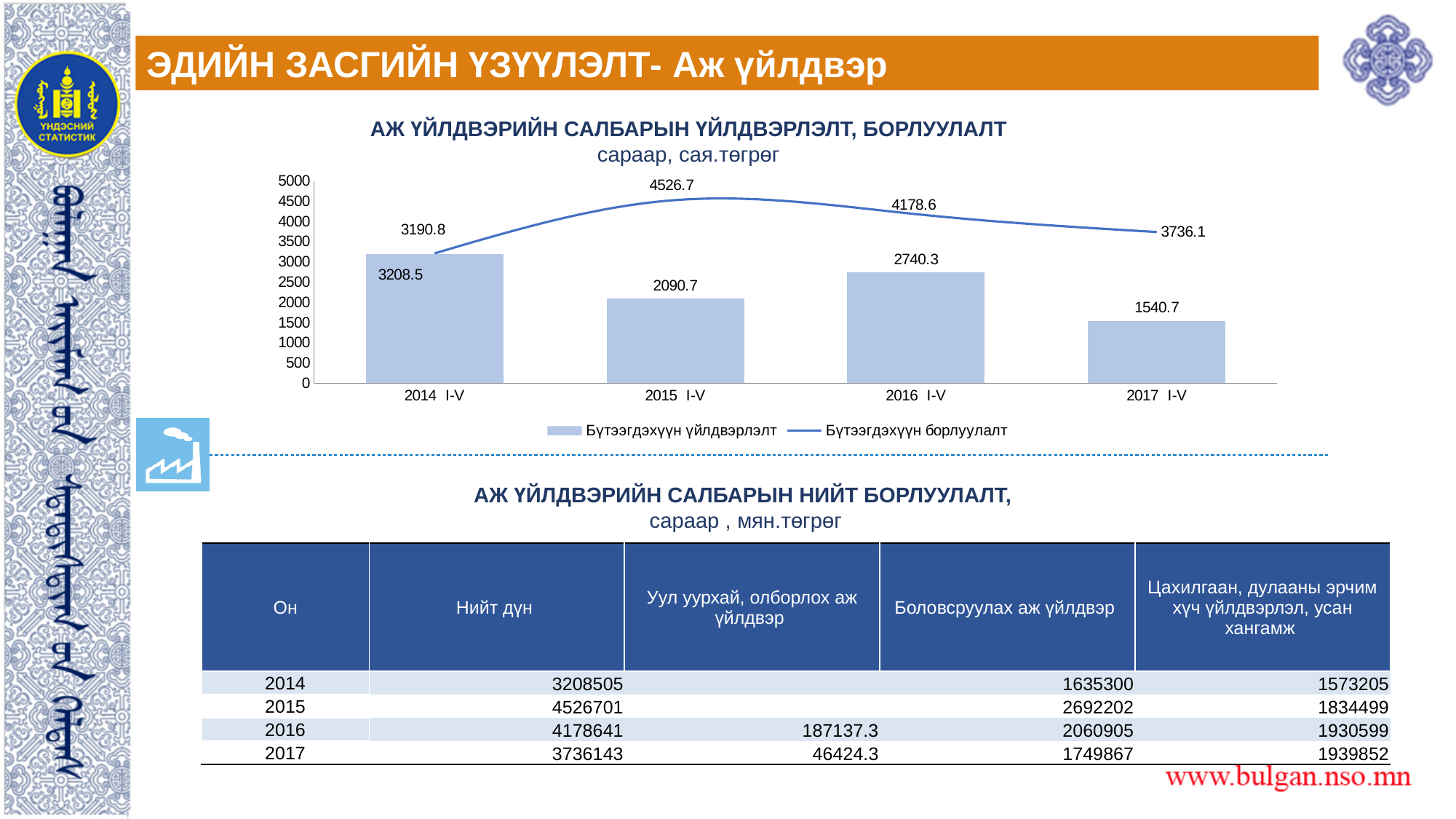
Does the Бүтээгдэхүүн борлуулалт line rise or fall from 2015 I-V to 2017 I-V? Fall What is the value of Бүтээгдэхүүн үйлдвэрлэлт for 2015 I-V? 2090.7 Which period has the highest value of Бүтээгдэхүүн үйлдвэрлэлт? 2014 I-V What unit is given in the chart subtitle? сая.төгрөг Which period has the lowest value of Бүтээгдэхүүн борлуулалт? 2014 I-V What is the value of Бүтээгдэхүүн борлуулалт for 2015 I-V? 4526.7 How many periods are shown on the x axis of the chart? 4 How many series does the chart legend list? 2 What is the difference between Бүтээгдэхүүн үйлдвэрлэлт in 2016 I-V and 2017 I-V? 1199.6 What is the value of Бүтээгдэхүүн үйлдвэрлэлт for 2017 I-V? 1540.7 Which is larger in 2016 I-V: Бүтээгдэхүүн үйлдвэрлэлт or Бүтээгдэхүүн борлуулалт? Бүтээгдэхүүн борлуулалт What type of chart is shown on the slide? Combined bar and line chart